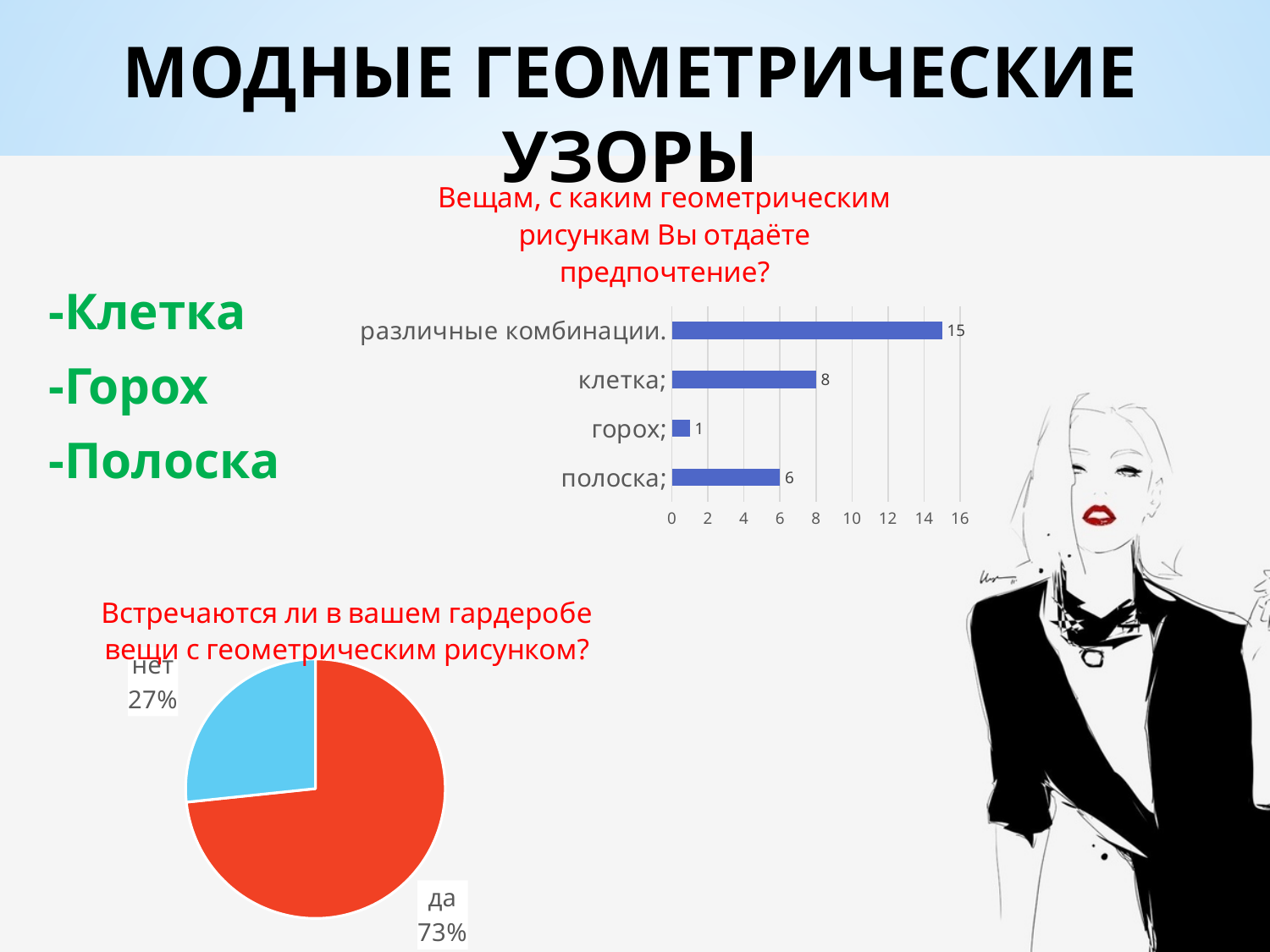
What kind of chart is the chart titled 'Встречаются ли в вашем гардеробе вещи с геометрическим рисунком?'? pie chart In the bar chart 'Вещам, с каким геометрическим рисункам Вы отдаёте предпочтение?', what is the value for 'полоска'? 6 In the bar chart 'Вещам, с каким геометрическим рисункам Вы отдаёте предпочтение?', how many categories are shown? 4 What kind of chart is the chart titled 'Вещам, с каким геометрическим рисункам Вы отдаёте предпочтение?'? bar chart In the bar chart 'Вещам, с каким геометрическим рисункам Вы отдаёте предпочтение?', what is the value for 'клетка'? 8 In the pie chart 'Встречаются ли в вашем гардеробе вещи с геометрическим рисунком?', what share does 'нет' have? 27% In the bar chart 'Вещам, с каким геометрическим рисункам Вы отдаёте предпочтение?', which category has the highest value? различные комбинации In the pie chart 'Встречаются ли в вашем гардеробе вещи с геометрическим рисунком?', what share does 'да' have? 73% In the bar chart 'Вещам, с каким геометрическим рисункам Вы отдаёте предпочтение?', what is the difference between 'различные комбинации' and 'клетка'? 7 In the bar chart 'Вещам, с каким геометрическим рисункам Вы отдаёте предпочтение?', which is larger: 'клетка' or 'полоска'? клетка In the bar chart 'Вещам, с каким геометрическим рисункам Вы отдаёте предпочтение?', which category has the lowest value? горох In the pie chart 'Встречаются ли в вашем гардеробе вещи с геометрическим рисунком?', which slice is larger: 'да' or 'нет'? да